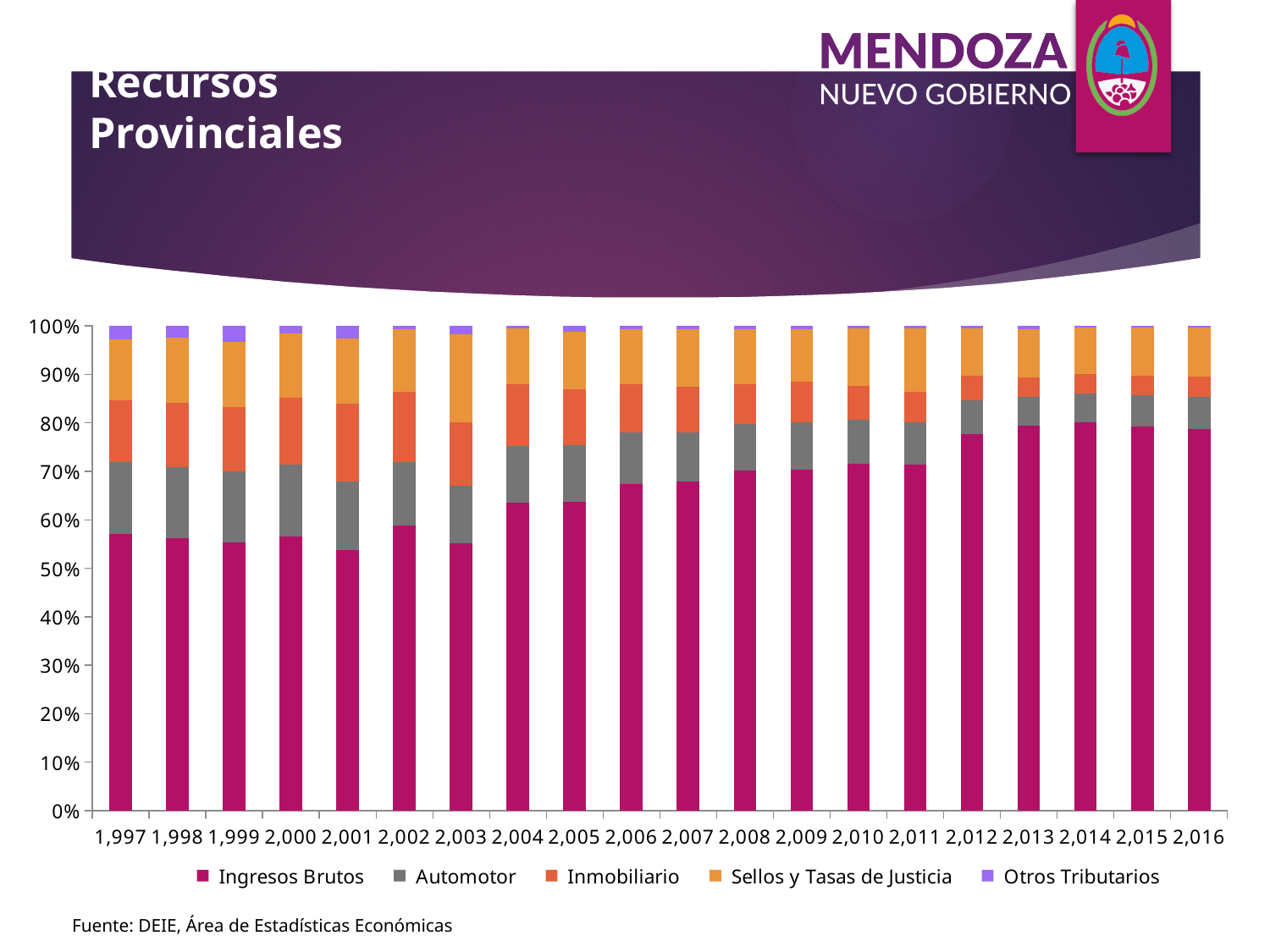
How many series does the legend list? 5 Does the Ingresos Brutos share generally rise or fall from 1997 to 2016? rise What is the source cited below the chart? DEIE, Área de Estadísticas Económicas How many years (categories) are plotted along the x axis? 20 Is the Ingresos Brutos share for 2001 greater or less than 60%? less What does each stacked bar total? 100% Which series is shown at the bottom of each stacked bar, in magenta? Ingresos Brutos What kind of chart is shown on the slide? stacked bar chart Is the Ingresos Brutos share for 2012 greater or less than 70%? greater Which year has the larger Ingresos Brutos share, 1997 or 2016? 2016 Is the Ingresos Brutos share for 1997 greater or less than 60%? less